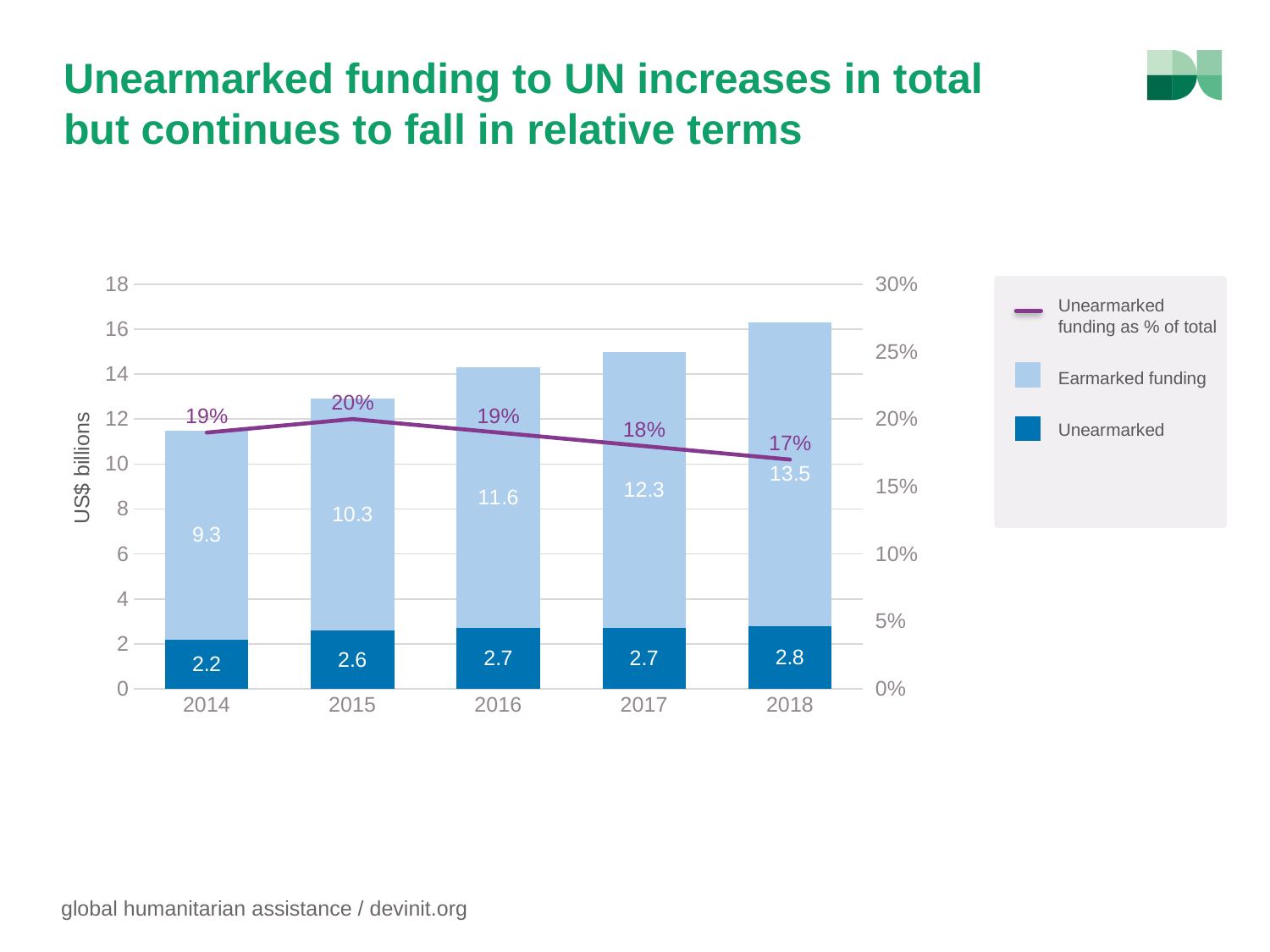
How many years are shown on the x axis? 5 What is the unearmarked funding value for 2014? 2.2 What is the label on the left vertical axis? US$ billions Which year has the highest earmarked funding? 2018 What is the difference between earmarked funding in 2018 and 2014? 4.2 What is the total of the stacked bar for 2017? 15.0 Which is larger, unearmarked funding in 2015 or in 2018? 2018 What is the earmarked funding value for 2016? 11.6 What is unearmarked funding as % of total in 2018? 17% How many series does the legend list? 3 Which year has the lowest unearmarked funding? 2014 Does unearmarked funding as % of total rise or fall from 2015 to 2018? fall